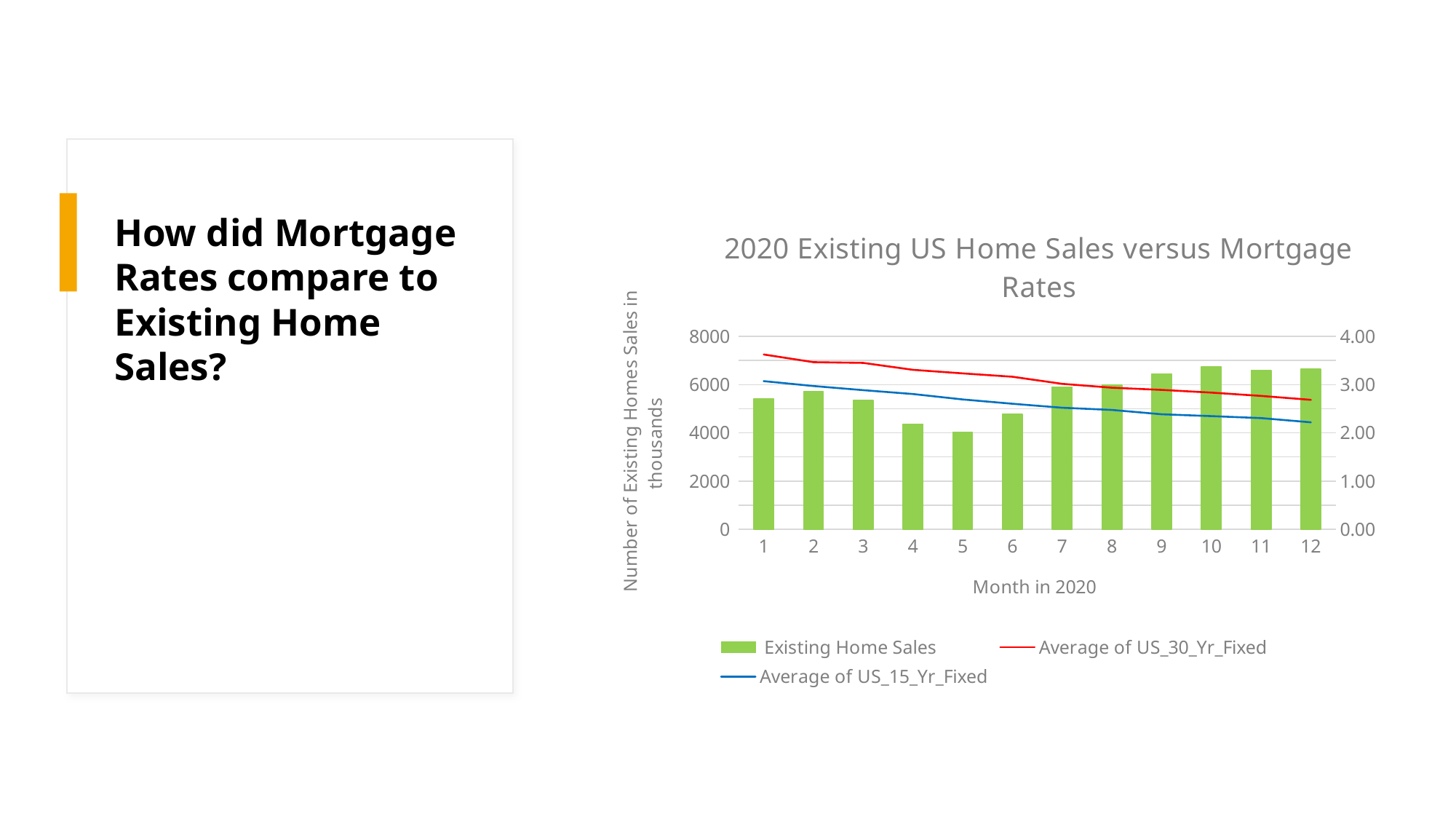
How many months are plotted along the x axis? 12 What kind of chart is shown on the slide? A combined bar and line chart Which month has higher Existing Home Sales, month 4 or month 9? Month 9 How many series does the legend list? 3 Does the Average of US_30_Yr_Fixed line rise or fall from month 1 to month 12? Fall Is the Existing Home Sales value for month 5 greater or less than 6000? less Which month has the lowest Existing Home Sales bar? 5 Which line is higher throughout the year, Average of US_30_Yr_Fixed or Average of US_15_Yr_Fixed? Average of US_30_Yr_Fixed What is the title of the chart? 2020 Existing US Home Sales versus Mortgage Rates Is the Average of US_15_Yr_Fixed value at month 12 greater or less than 3.00? less Is the Existing Home Sales value for month 10 greater or less than 6000? greater Which month has higher Existing Home Sales, month 2 or month 5? Month 2